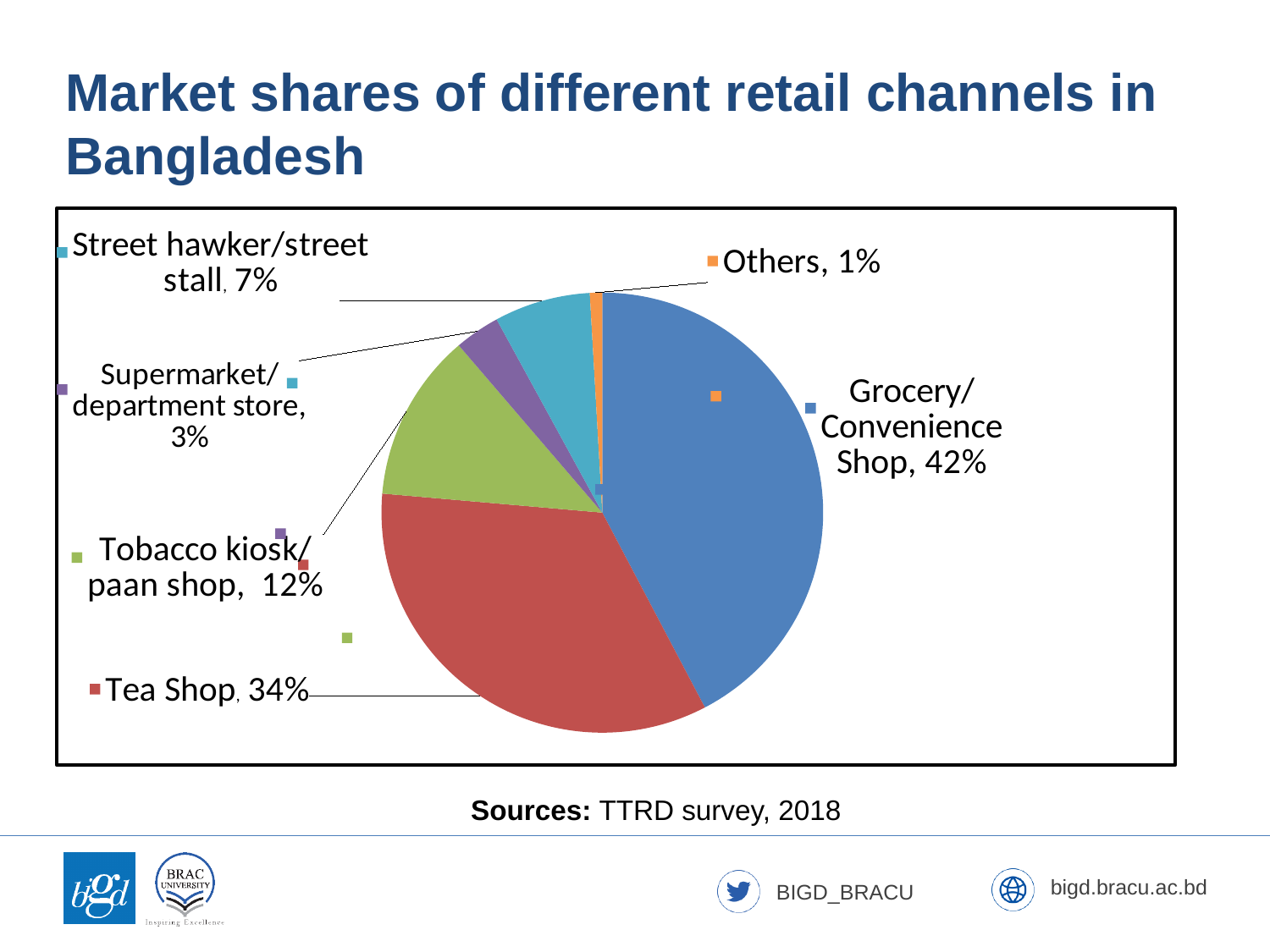
Which has a larger market share, Tobacco kiosk/paan shop or Street hawker/street stall? Tobacco kiosk/paan shop What is the market share of Street hawker/street stall? 7% What kind of chart is shown on the slide? pie chart What is the market share of Tea Shop? 34% Which retail channel has the largest market share? Grocery/Convenience Shop What is the market share of Grocery/Convenience Shop? 42% What is the difference in market share between Grocery/Convenience Shop and Tea Shop? 8% Which retail channel has the smallest market share? Others What is the source cited for the chart? TTRD survey, 2018 What is the market share of Tobacco kiosk/paan shop? 12% What is the market share of Supermarket/department store? 3% How many retail channels are shown in the pie chart? 6